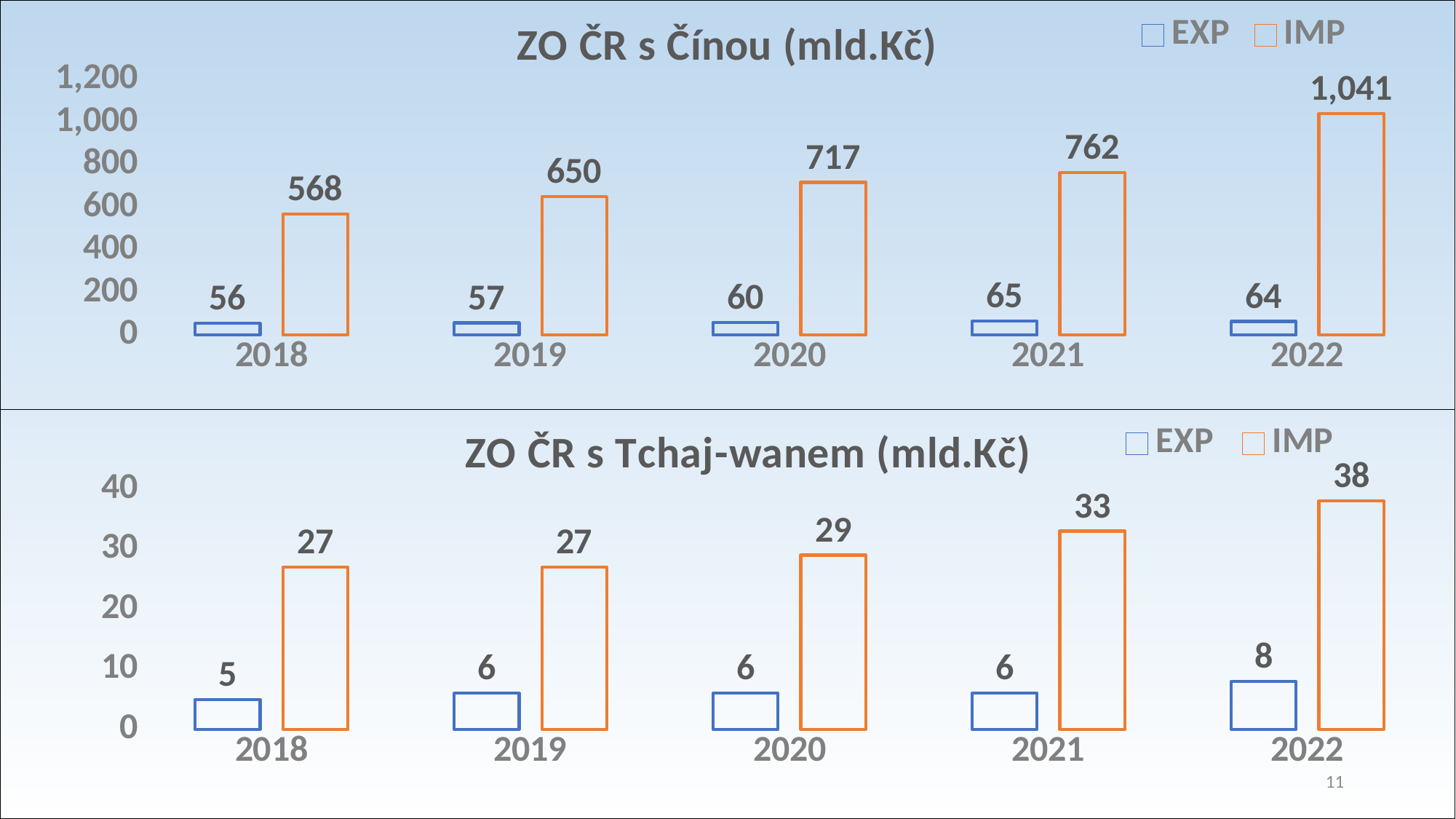
In the chart 'ZO ČR s Tchaj-wanem (mld.Kč)', which year has the lowest EXP value? 2018 In the chart 'ZO ČR s Tchaj-wanem (mld.Kč)', what is the EXP value for 2018? 5 In the chart 'ZO ČR s Tchaj-wanem (mld.Kč)', what is the IMP value for 2021? 33 In the chart 'ZO ČR s Čínou (mld.Kč)', which year has the highest IMP value? 2022 What kind of chart is 'ZO ČR s Tchaj-wanem (mld.Kč)'? Bar chart In the chart 'ZO ČR s Čínou (mld.Kč)', what is the IMP value for 2022? 1,041 In the chart 'ZO ČR s Čínou (mld.Kč)', what is the EXP value for 2020? 60 In the chart 'ZO ČR s Čínou (mld.Kč)', what is the difference between the IMP values for 2022 and 2021? 279 In the chart 'ZO ČR s Čínou (mld.Kč)', do the IMP values rise or fall from 2018 to 2022? rise In the chart 'ZO ČR s Čínou (mld.Kč)', how many series does the legend list? 2 In the chart 'ZO ČR s Tchaj-wanem (mld.Kč)', is the IMP value for 2022 larger than the IMP value for 2020? Yes In the chart 'ZO ČR s Tchaj-wanem (mld.Kč)', how many years are shown on the x axis? 5